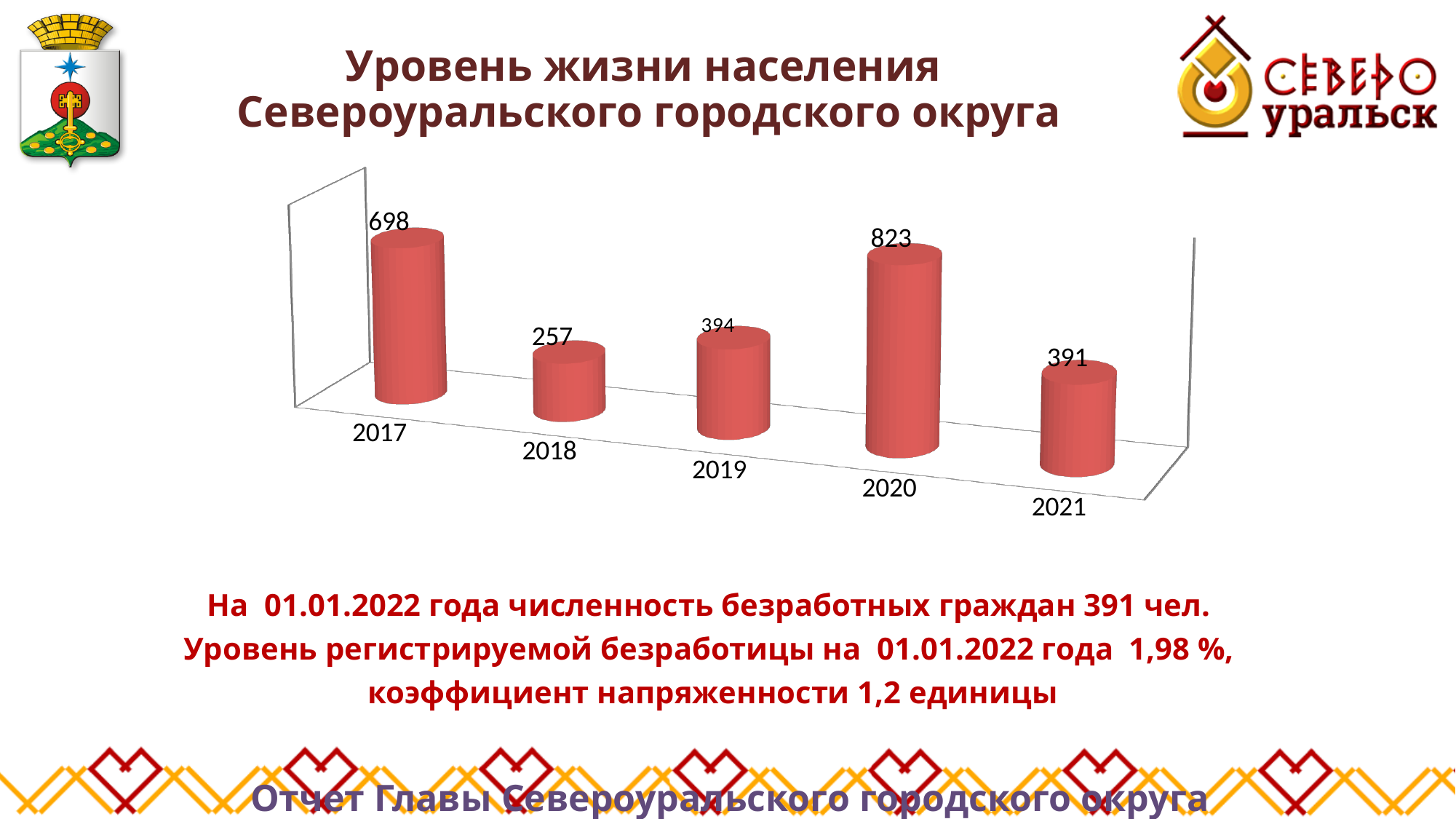
What is the difference between the values for 2017 and 2018? 441 What is the difference between the values for 2020 and 2021? 432 What kind of chart is shown on the slide? bar chart Does the value rise or fall from 2020 to 2021? fall How many years are shown on the chart? 5 What is the value shown for 2017? 698 Which year has the highest value? 2020 What is the value shown for 2018? 257 Which is larger, the value for 2019 or the value for 2021? 2019 Which year has the lowest value? 2018 What is the value shown for 2021? 391 What is the value shown for 2020? 823